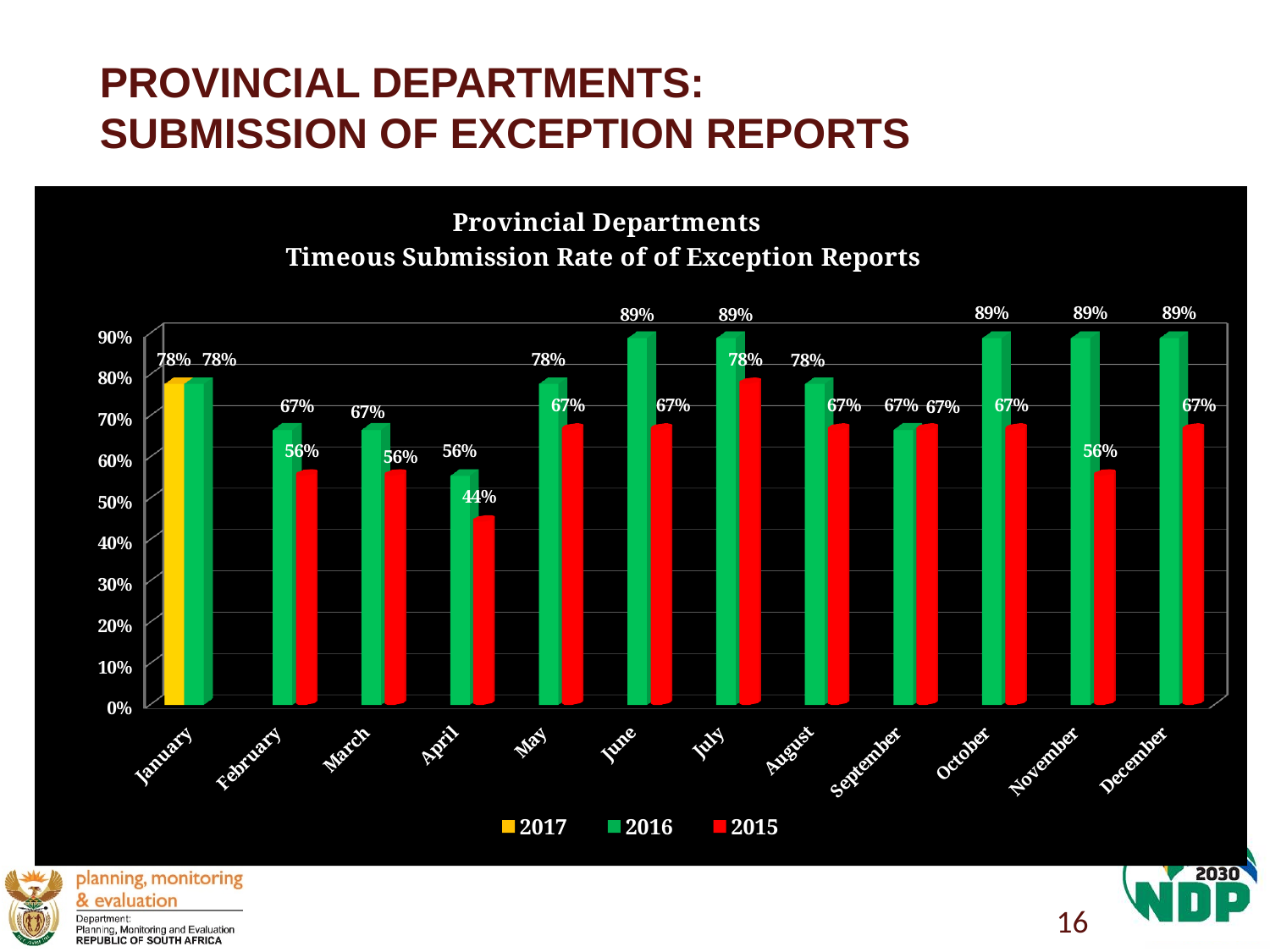
Which is larger in May, the 2016 value or the 2015 value? 2016 What is the difference between the 2016 and 2015 values for November? 33% How many series does the legend list? 3 What is the 2016 value for June? 89% What is the 2017 value for January? 78% How many months are shown on the x axis? 12 What is the 2015 value for November? 56% Which month has the lowest 2015 value? April Which month has the highest 2015 value? July What is the 2015 value for April? 44% Which colour represents the 2015 series in the legend? Red What kind of chart is shown on the slide? Bar chart